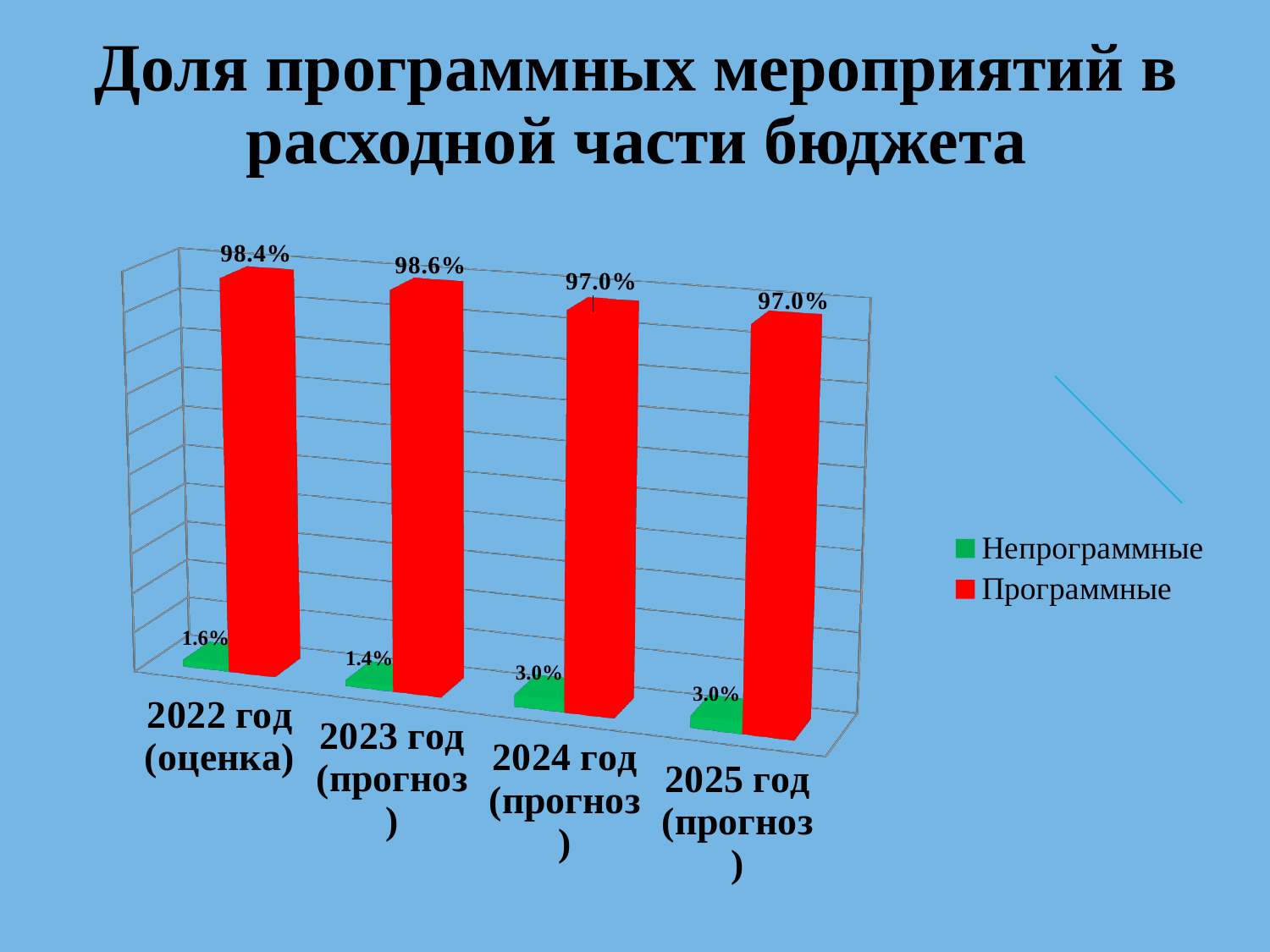
How many year categories are shown on the x axis? 4 What is the value for Программные in 2022 год (оценка)? 98.4% Which colour represents the Непрограммные series? Green How many series does the legend list? 2 In which year is the Непрограммные share lowest? 2023 год (прогноз) What is the difference between the Программные values for 2023 год (прогноз) and 2024 год (прогноз)? 1.6% Which is larger: the Непрограммные value for 2022 год (оценка) or for 2025 год (прогноз)? 2025 год (прогноз) What is the value for Непрограммные in 2024 год (прогноз)? 3.0% What kind of chart is shown on the slide? Bar chart In which year is the Программные share highest? 2023 год (прогноз) What is the value for Непрограммные in 2023 год (прогноз)? 1.4% What is the value for Программные in 2025 год (прогноз)? 97.0%